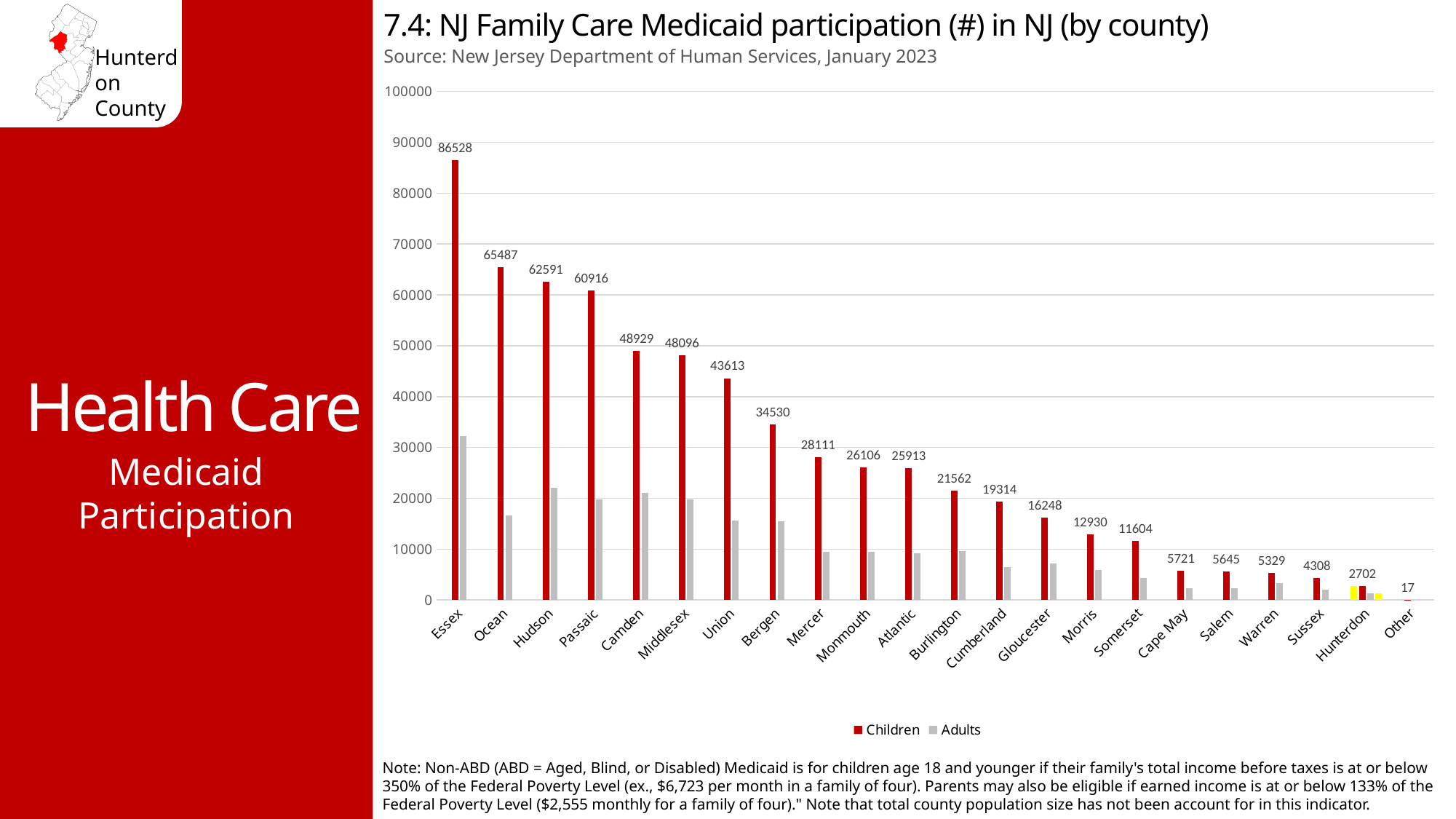
What is the difference between the Children values for Essex and Ocean? 21041 How many categories are shown on the x axis? 22 What is the Children value for Hunterdon? 2702 What kind of chart is shown? bar chart Is the Adults value for Ocean greater or less than 20000? less What is the Children value for Bergen? 34530 Which county (excluding Other) has the lowest Children value? Hunterdon Which county has the highest Children value? Essex How many series does the legend list? 2 Is the Adults value for Essex greater or less than 30000? greater Which has a larger Children value, Camden or Middlesex? Camden What is the Children value for Essex? 86528